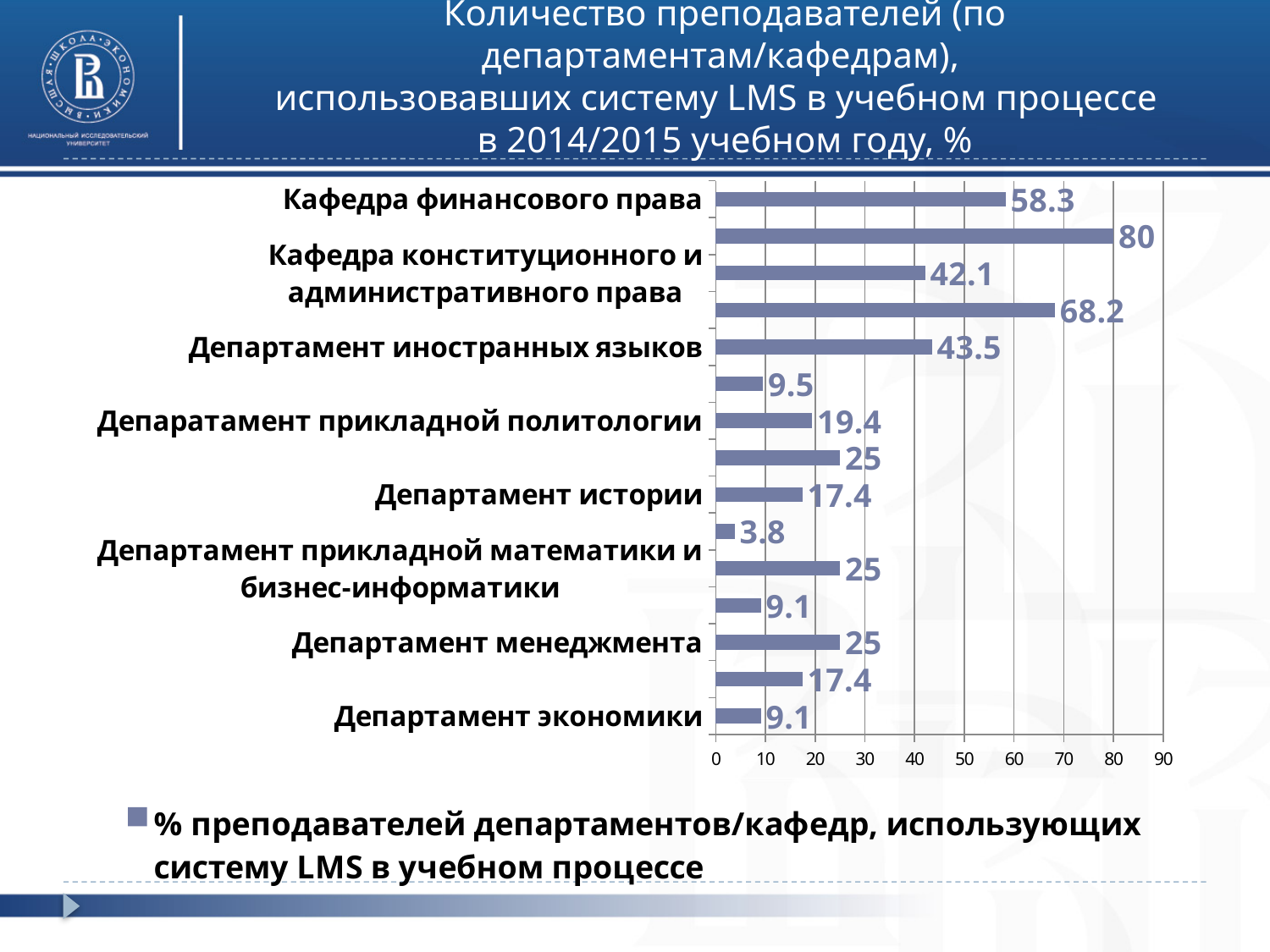
What is the value for Кафедра финансового права? 58.3 How many series does the legend list? 1 What is the highest value shown on the chart? 80 What kind of chart is shown on the slide? bar chart What is the lowest value shown on the chart? 3.8 How many bars are plotted on the chart? 15 What is the value for Департамент экономики? 9.1 What is the value for Департамент менеджмента? 25 What is the value for Департамент истории? 17.4 What is the value for Департамент иностранных языков? 43.5 What is the difference between the values for Кафедра финансового права and Департамент экономики? 49.2 Which is larger, the value for Департамент иностранных языков or the value for Департамент истории? Департамент иностранных языков